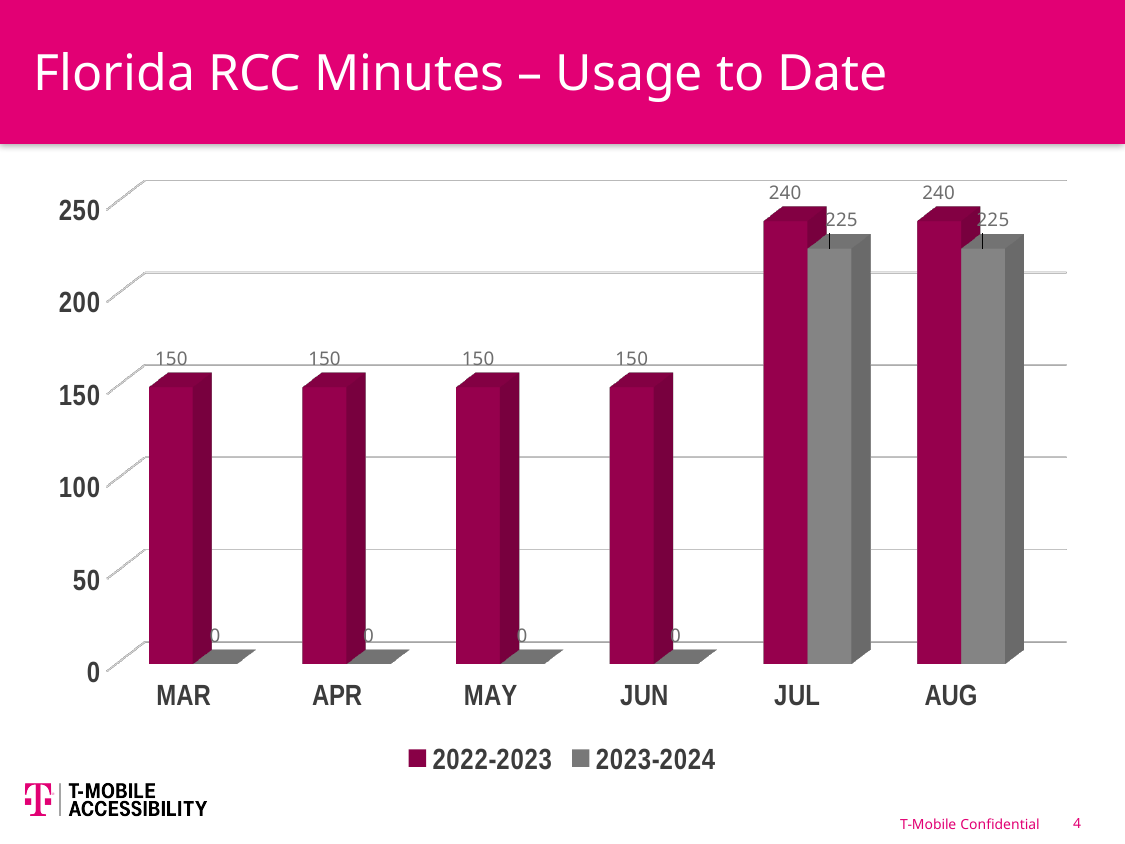
What is the value for 2023-2024 in AUG? 225 What is the difference between the 2022-2023 and 2023-2024 values in JUL? 15 Is the 2022-2023 value for JUN greater or less than 200? less How many months are shown on the x axis? 6 What is the value for 2022-2023 in MAR? 150 What is the value for 2022-2023 in JUL? 240 What is the difference between the 2022-2023 values for JUL and JUN? 90 Which is larger in AUG, the 2022-2023 value or the 2023-2024 value? 2022-2023 What kind of chart is shown on the slide? bar chart What is the value for 2023-2024 in MAY? 0 What is the title of the slide? Florida RCC Minutes – Usage to Date How many series does the legend list? 2